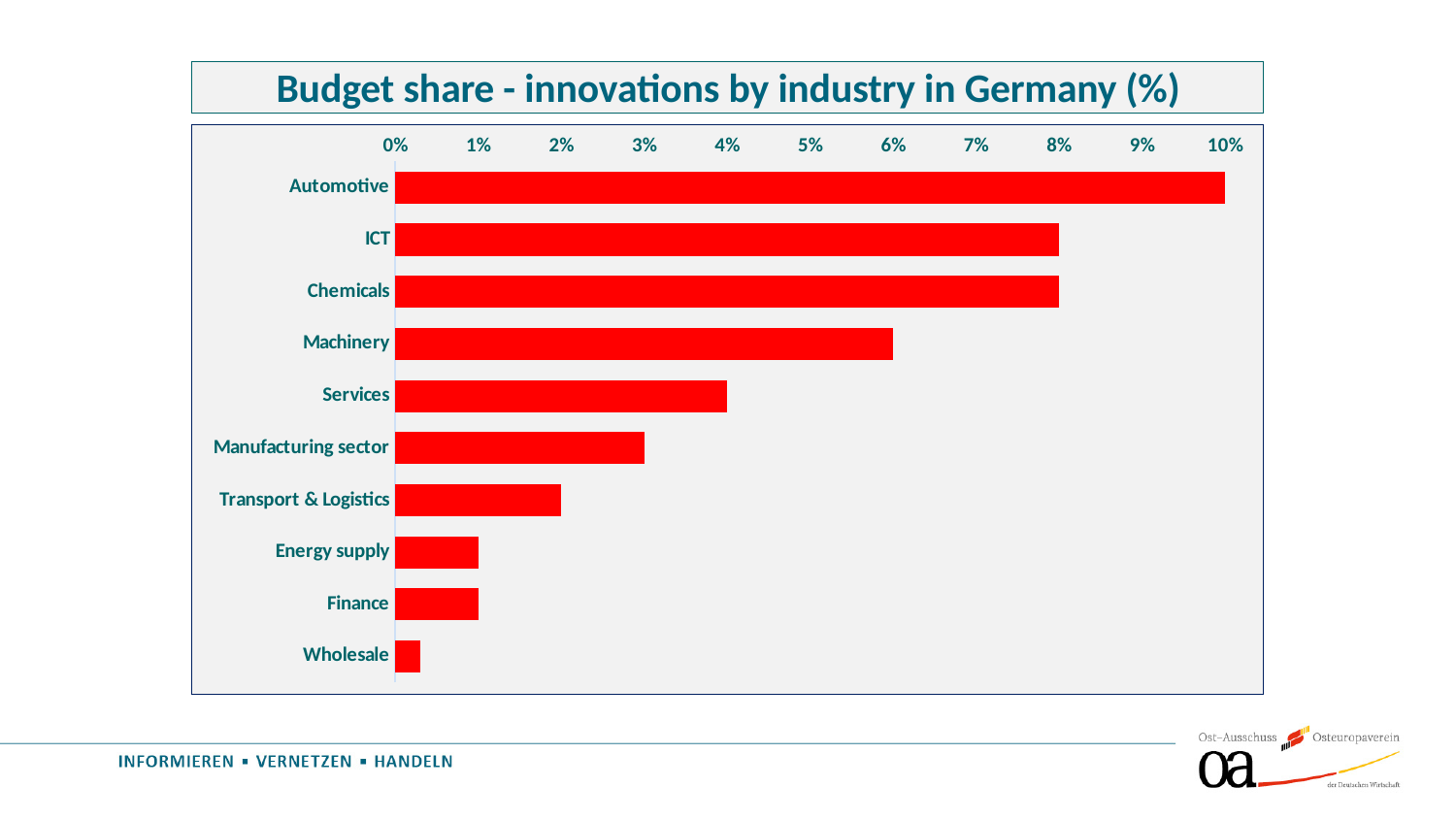
Is the value for Wholesale greater or less than 1%? less Is the value for Automotive greater or less than 9%? greater Is the value for Services greater or less than 5%? less Which industry has the highest budget share for innovations? Automotive Which has a larger budget share, Services or Manufacturing sector? Services Which has a larger budget share, Machinery or Services? Machinery Which industry has the lowest budget share for innovations? Wholesale What colour are the bars in the chart? Red How many industries are shown in the chart? 10 What is the title of the chart? Budget share - innovations by industry in Germany (%) What kind of chart is shown on the slide? Bar chart